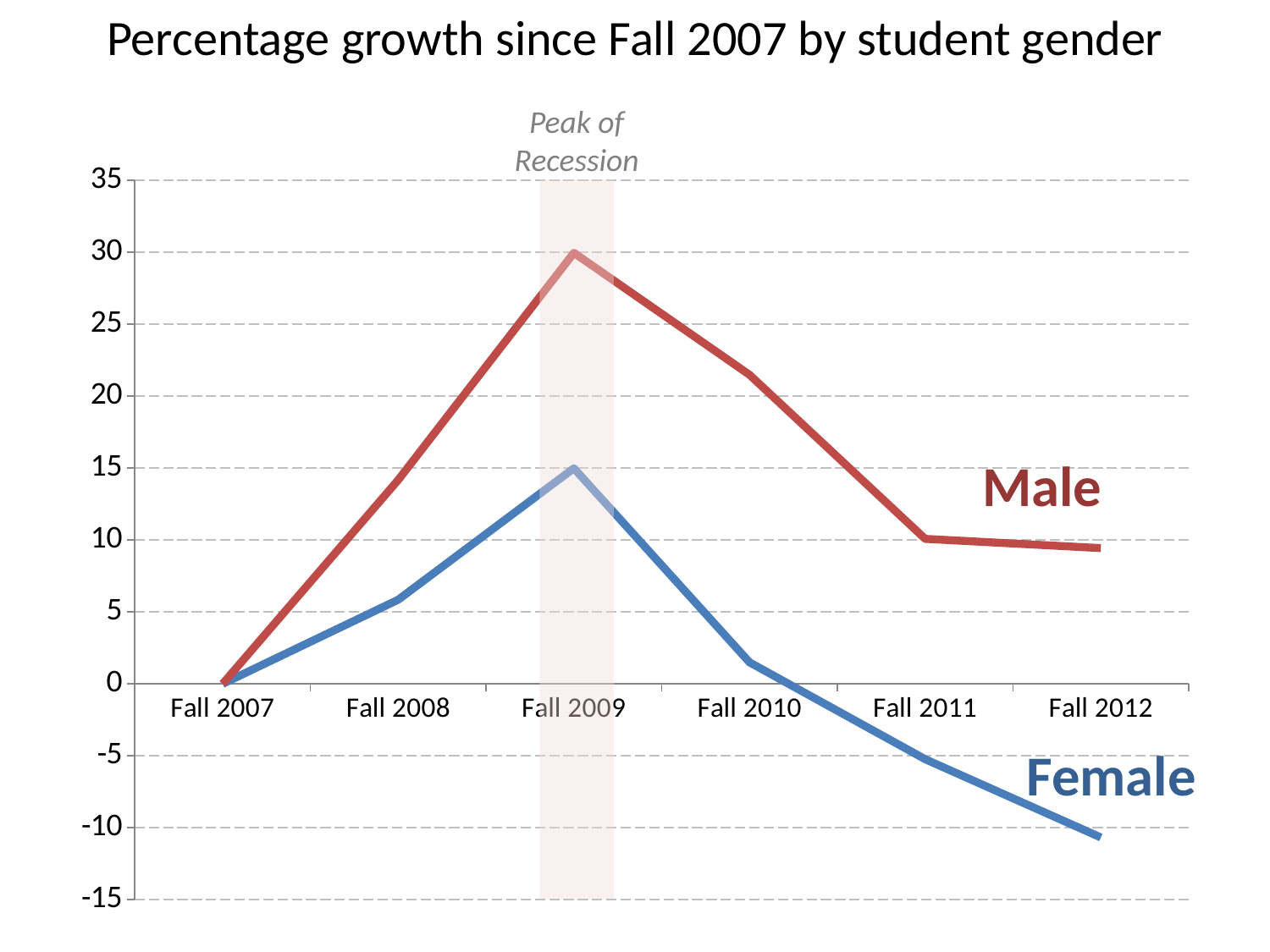
At which point does the Female series reach its lowest value? Fall 2012 Does the Female series rise or fall from Fall 2009 to Fall 2012? fall How many series are plotted on the chart? 2 Is the Female value at Fall 2012 greater or less than -5? less At Fall 2010, which series has the larger value, Male or Female? Male At which point does the Male series reach its highest value? Fall 2009 How many time points are shown along the x axis? 6 Is the Male value at Fall 2010 greater or less than 20? greater What kind of chart is shown on the slide? line chart